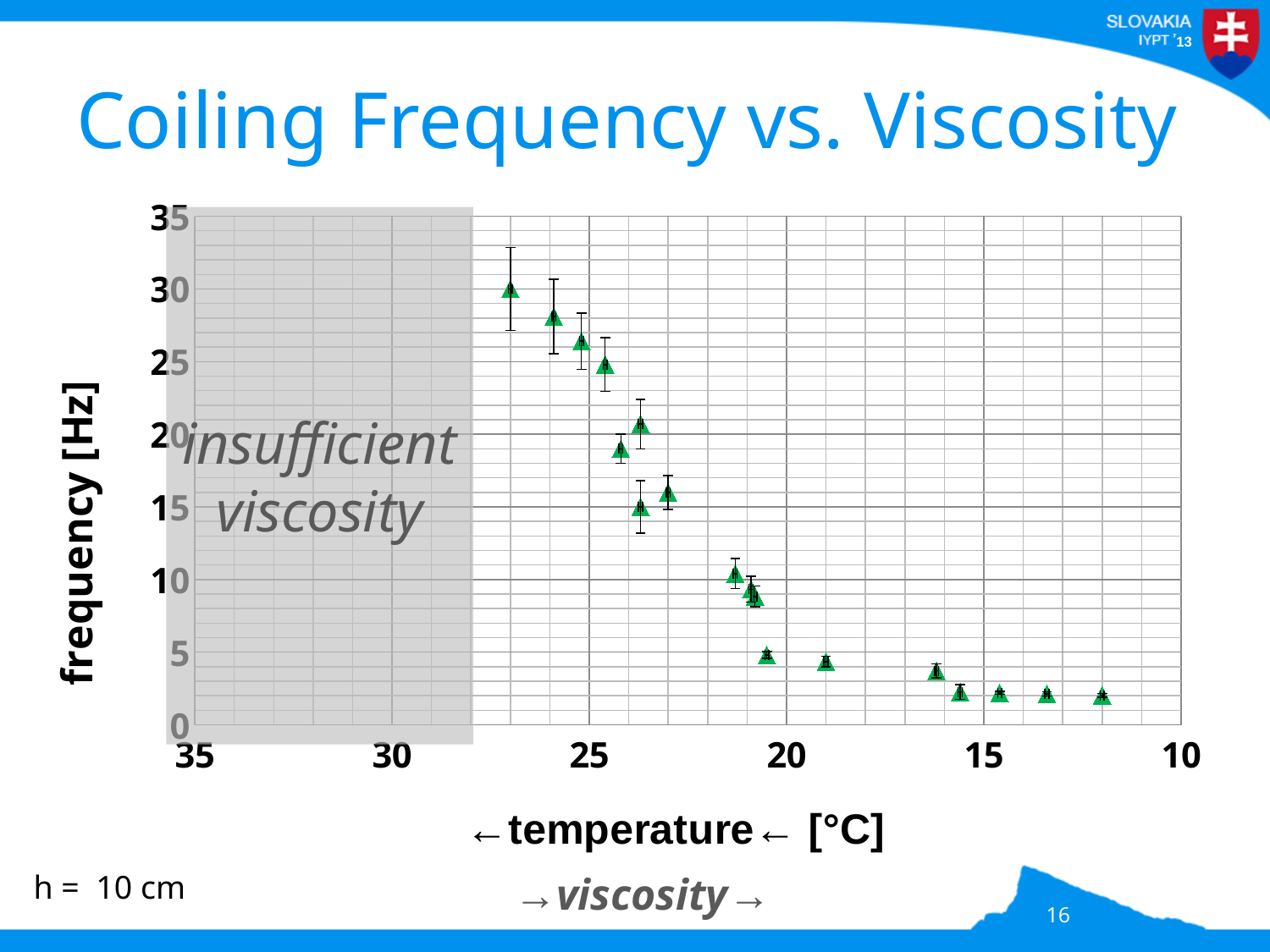
Is the frequency of the data point at about 12 °C greater or less than 5 Hz? less Is the frequency of the data point at about 21 °C greater or less than 15 Hz? less Is the frequency of the data point at about 25 °C greater or less than 20 Hz? greater Which data point has the lower frequency: the one at about 23 °C or the one at about 16 °C? the one at about 16 °C What does the shaded grey region on the left of the chart indicate? insufficient viscosity What is the title of the chart? Coiling Frequency vs. Viscosity Moving from left to right along the x axis (from 35 °C toward 10 °C), does the coiling frequency rise or fall? fall What kind of chart is shown on the slide? scatter plot Which data point has the highest frequency: the one at about 27 °C or the one at about 20 °C? the one at about 27 °C